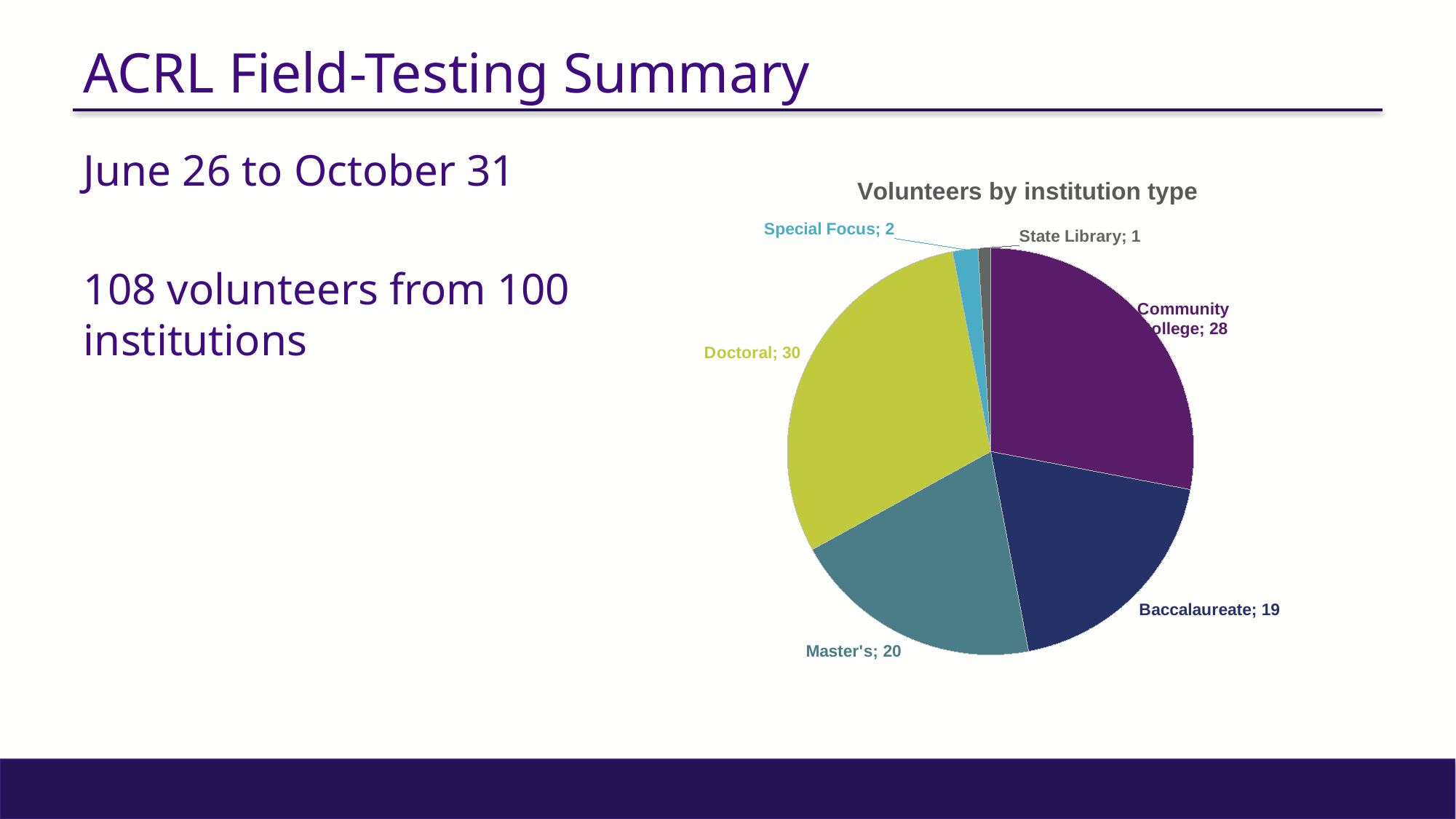
What kind of chart is shown on the slide? pie chart What share of the pie does the Doctoral slice represent? 30% Which has more volunteers, Master's or Baccalaureate? Master's What is the title of the chart? Volunteers by institution type How many volunteers are from Baccalaureate institutions? 19 How many institution types are shown in the pie chart? 6 Which institution type has the fewest volunteers? State Library How many volunteers are from State Library institutions? 1 What is the difference between the number of volunteers from Doctoral and Master's institutions? 10 How many volunteers are from Doctoral institutions? 30 Which institution type has the most volunteers? Doctoral How many volunteers are from Community College institutions? 28